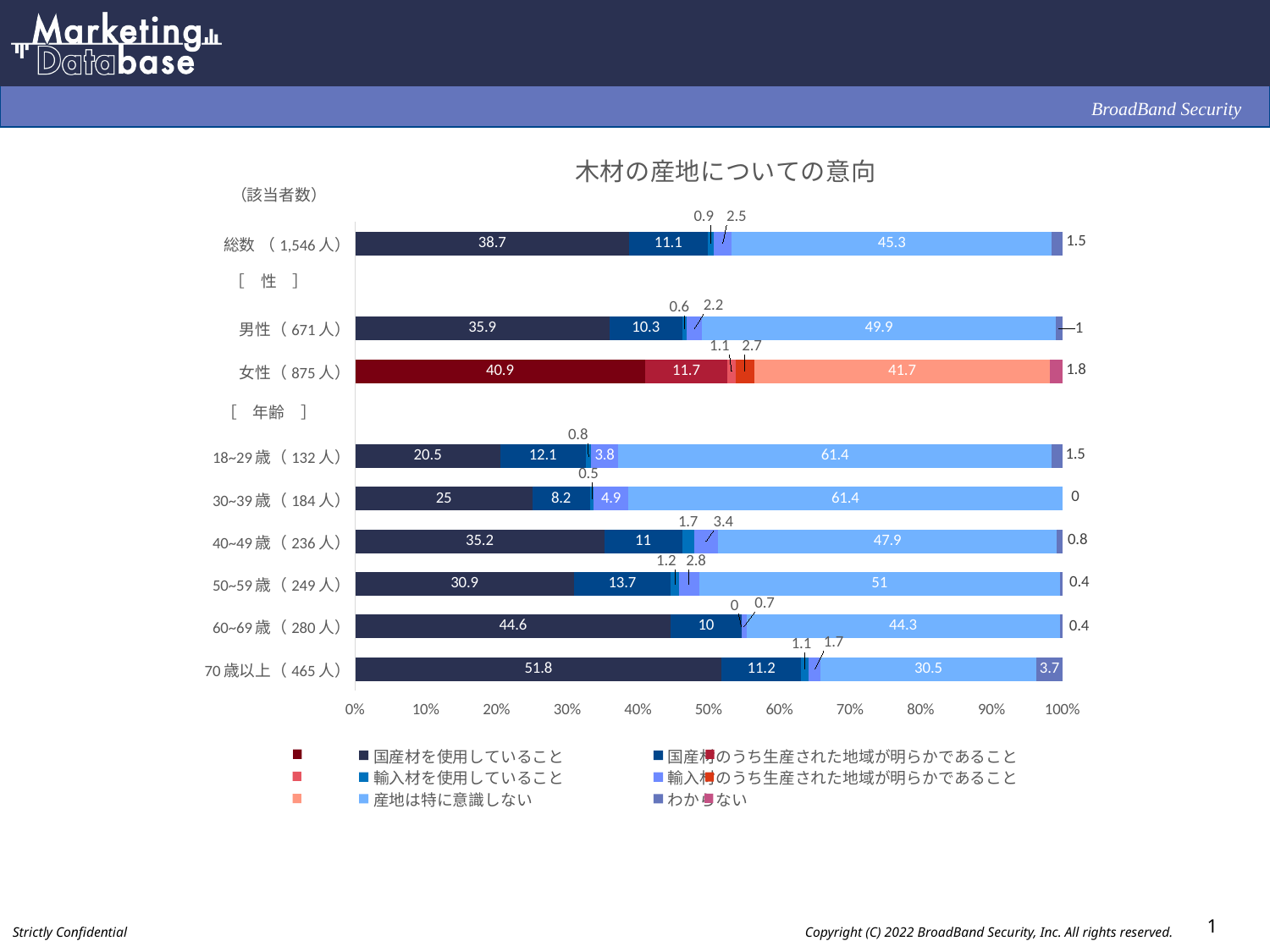
What is the value for 産地は特に意識しない for 男性 (671人)? 49.9 What is the value for 国産材を使用していること for 総数 (1,546人)? 38.7 Which category has the lowest value for 産地は特に意識しない? 70歳以上 (465人) How many series does the legend list? 6 Across the age groups from 18~29歳 to 70歳以上, does the value for 産地は特に意識しない generally rise or fall? Fall How many categories (bars) are plotted in the chart? 9 What is the value for 輸入材を使用していること for 60~69歳 (280人)? 0 Which is larger for 産地は特に意識しない: 18~29歳 (132人) or 50~59歳 (249人)? 18~29歳 (132人) What kind of chart is shown on the slide? Stacked bar chart What is the value for わからない for 70歳以上 (465人)? 3.7 What is the difference between 女性 (875人) and 男性 (671人) for 国産材を使用していること? 5 Which category has the highest value for 国産材を使用していること? 70歳以上 (465人)